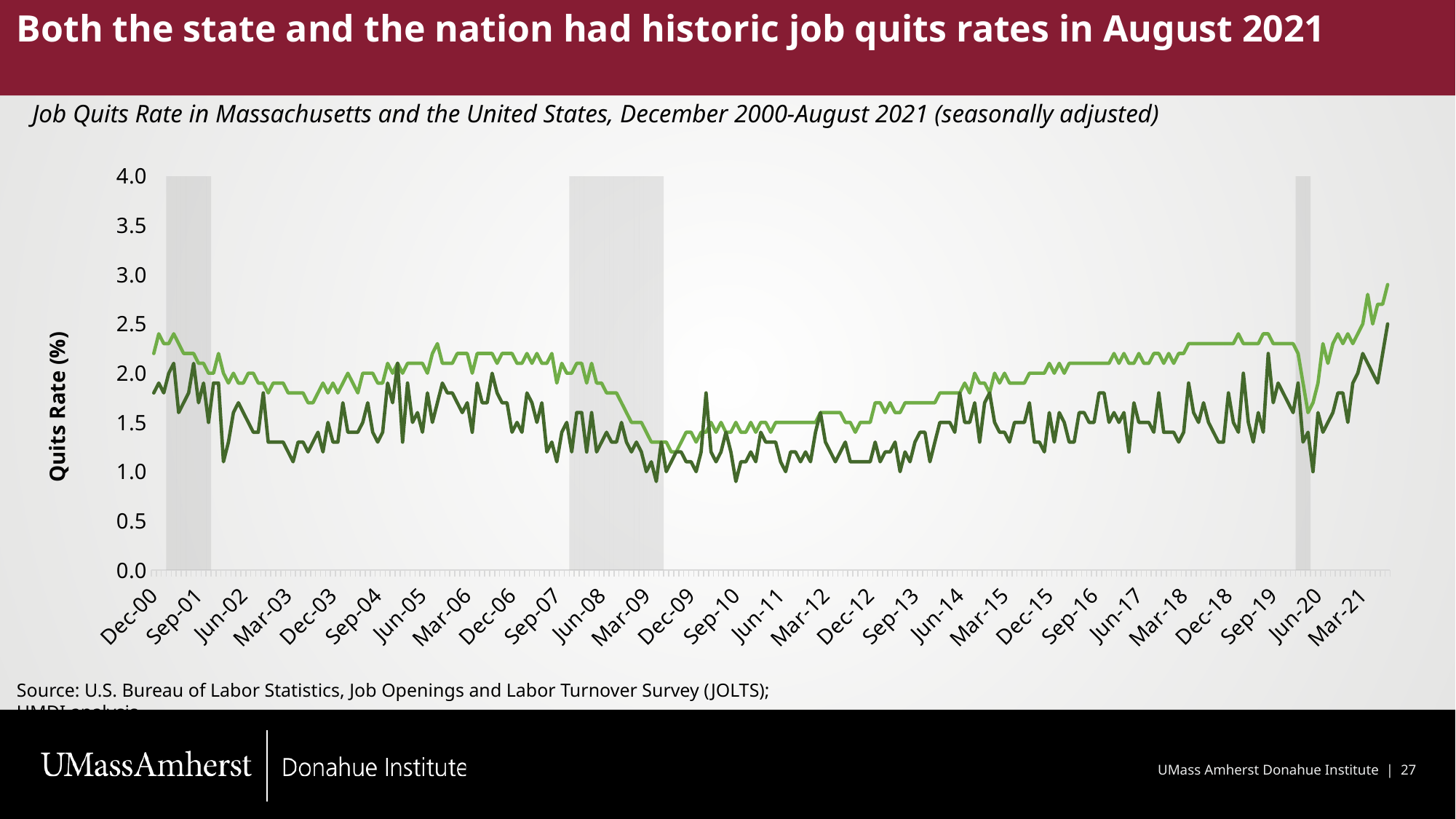
Do the two lines rise or fall between Jun-20 and Mar-21? rise How many lines are plotted on the chart? 2 Which line is higher at Mar-21, the light green line or the dark green line? the light green line What is the label on the vertical axis of the chart? Quits Rate (%) Is the value of the light green line around Jun-11 greater or less than 2.0? less Is the value of the light green line at the end of the series (after Mar-21) greater or less than 2.5? greater Is the value of the dark green line around Mar-09 greater or less than 1.5? less What is the title of the chart? Job Quits Rate in Massachusetts and the United States, December 2000-August 2021 (seasonally adjusted) What is the highest value shown on the vertical axis? 4.0 What kind of chart is shown on the slide? line chart